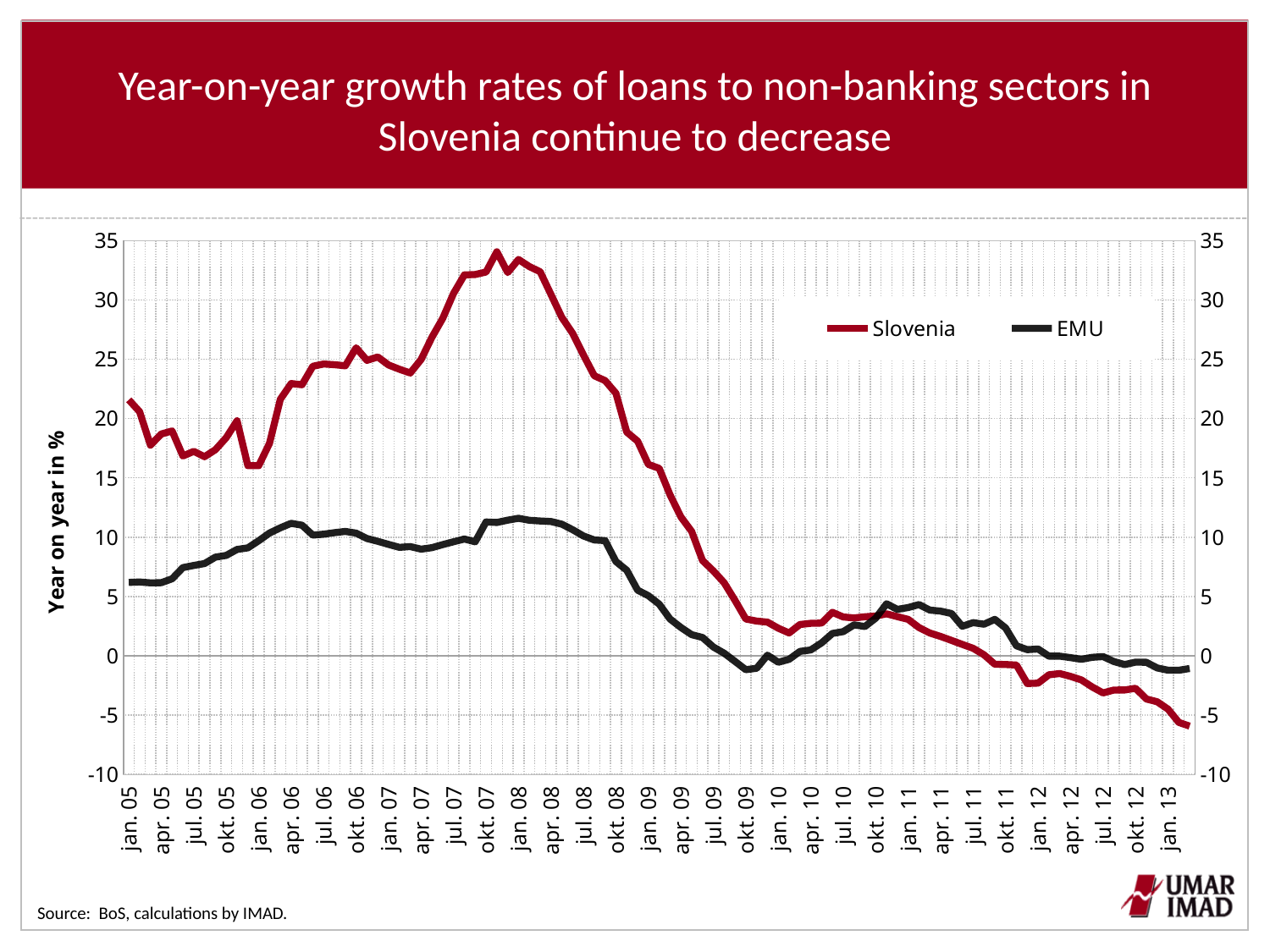
At jan. 13, which series has the higher value, Slovenia or EMU? EMU What kind of chart is shown on the slide? Line chart What is the label of the vertical axis? Year on year in % Is the value for Slovenia at jan. 13 greater or less than 0? less Is the value for Slovenia at jan. 05 greater or less than 20? greater Does the Slovenia series rise or fall between jan. 08 and jan. 13? Fall How many series does the legend list? 2 Which two series are listed in the legend? Slovenia and EMU Which series reaches the highest value anywhere on the chart? Slovenia Is the value for EMU at jan. 08 greater or less than 10? greater At jan. 05, which series has the higher value, Slovenia or EMU? Slovenia